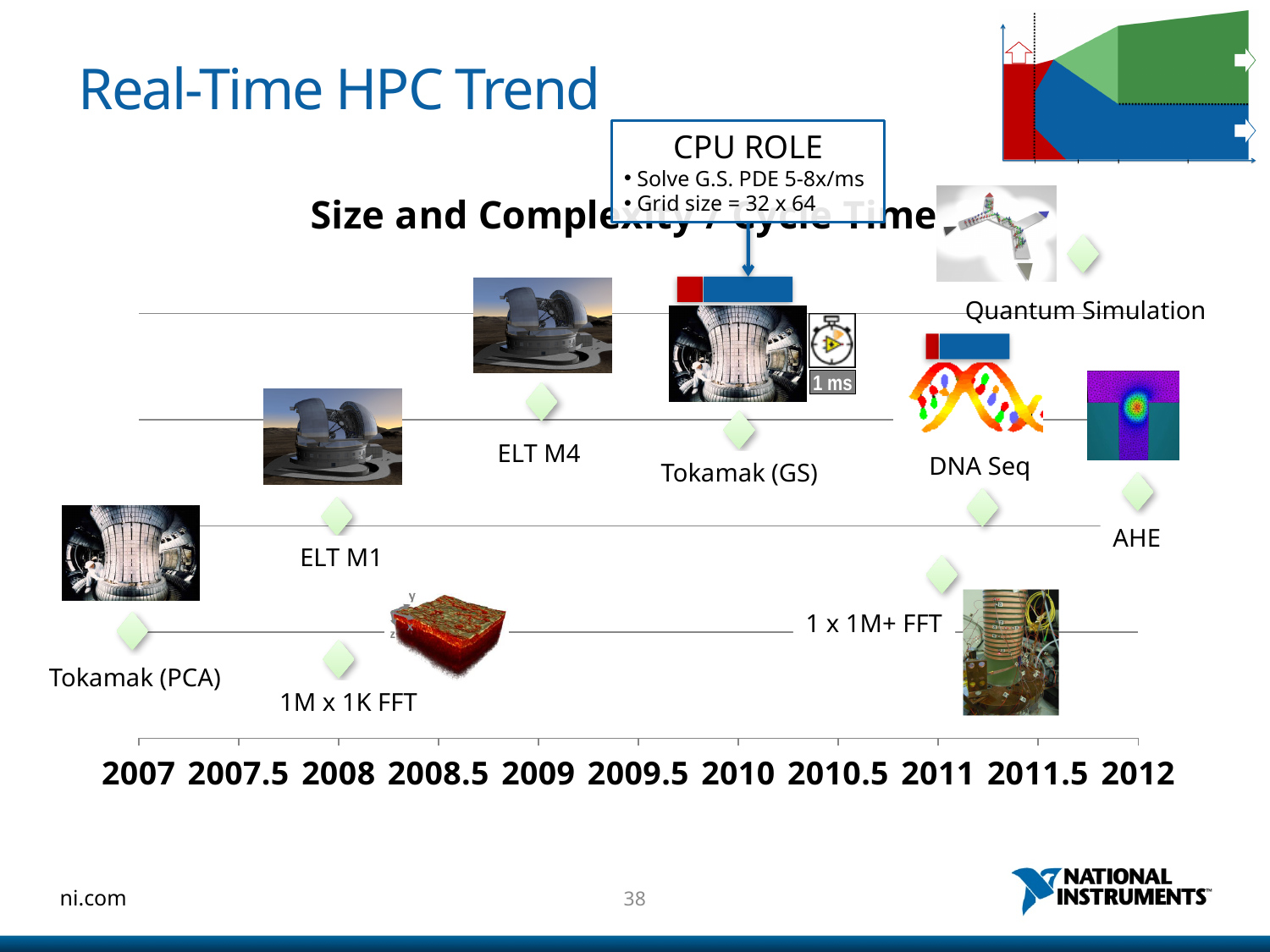
Which data point is plotted earliest on the x axis? Tokamak (PCA) Which is plotted earlier on the x axis, ELT M1 or DNA Seq? ELT M1 What is the title of the chart? Size and Complexity / Cycle Time What kind of chart is shown on the slide? scatter chart Do the plotted points rise or fall along the x axis from 2007 to 2012? rise What is the first year label on the x axis of the chart? 2007 Is the x-axis position of ELT M4 greater or less than 2008.5? greater Which data point is plotted latest on the x axis? AHE Which data point is plotted highest on the chart? Quantum Simulation How many labeled data points are plotted on the chart? 9 Which is plotted higher on the chart, AHE or Tokamak (PCA)? AHE Is the x-axis position of Tokamak (GS) greater or less than 2009.5? greater